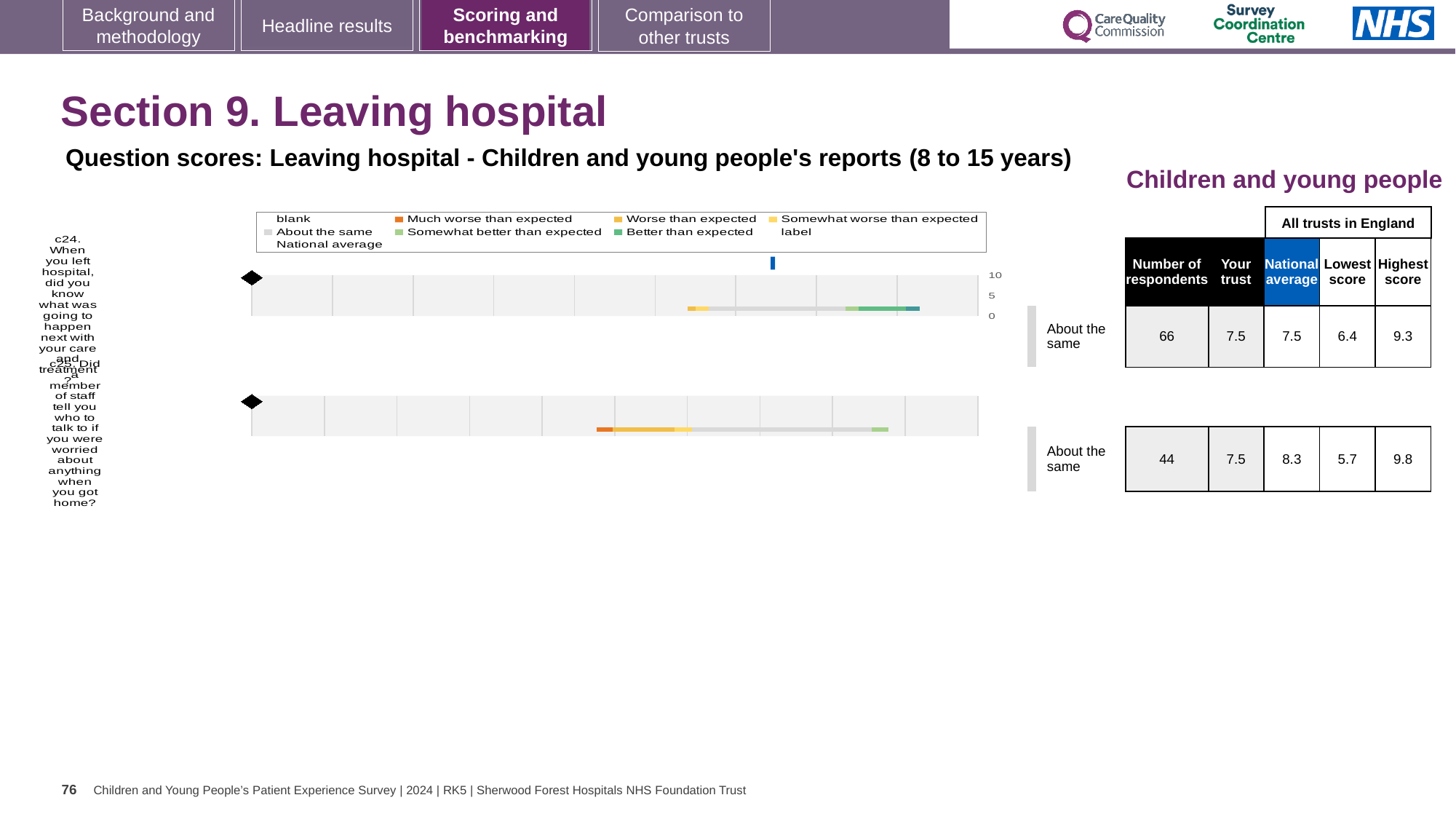
What kind of chart is used to show the question scores for Leaving hospital? bar chart What is the national average score for question c25 (Did a member of staff tell you who to talk to if you were worried about anything when you got home?)? 8.3 What is the 'Your trust' score for question c24 (When you left hospital, did you know what was going to happen next with your care and treatment?)? 7.5 What benchmark category is shown for question c24? About the same By how much does the national average exceed the 'Your trust' score for question c25? 0.8 What is the difference between the highest score and the lowest score for question c24? 2.9 How many questions are plotted in the Leaving hospital chart? 2 What is the title of the chart on this slide? Question scores: Leaving hospital - Children and young people's reports (8 to 15 years) For question c25, which is larger: the 'Your trust' score or the national average? National average What is the highest score among all trusts in England for question c25? 9.8 Which question has more respondents, c24 or c25? c24 How many respondents answered question c24? 66